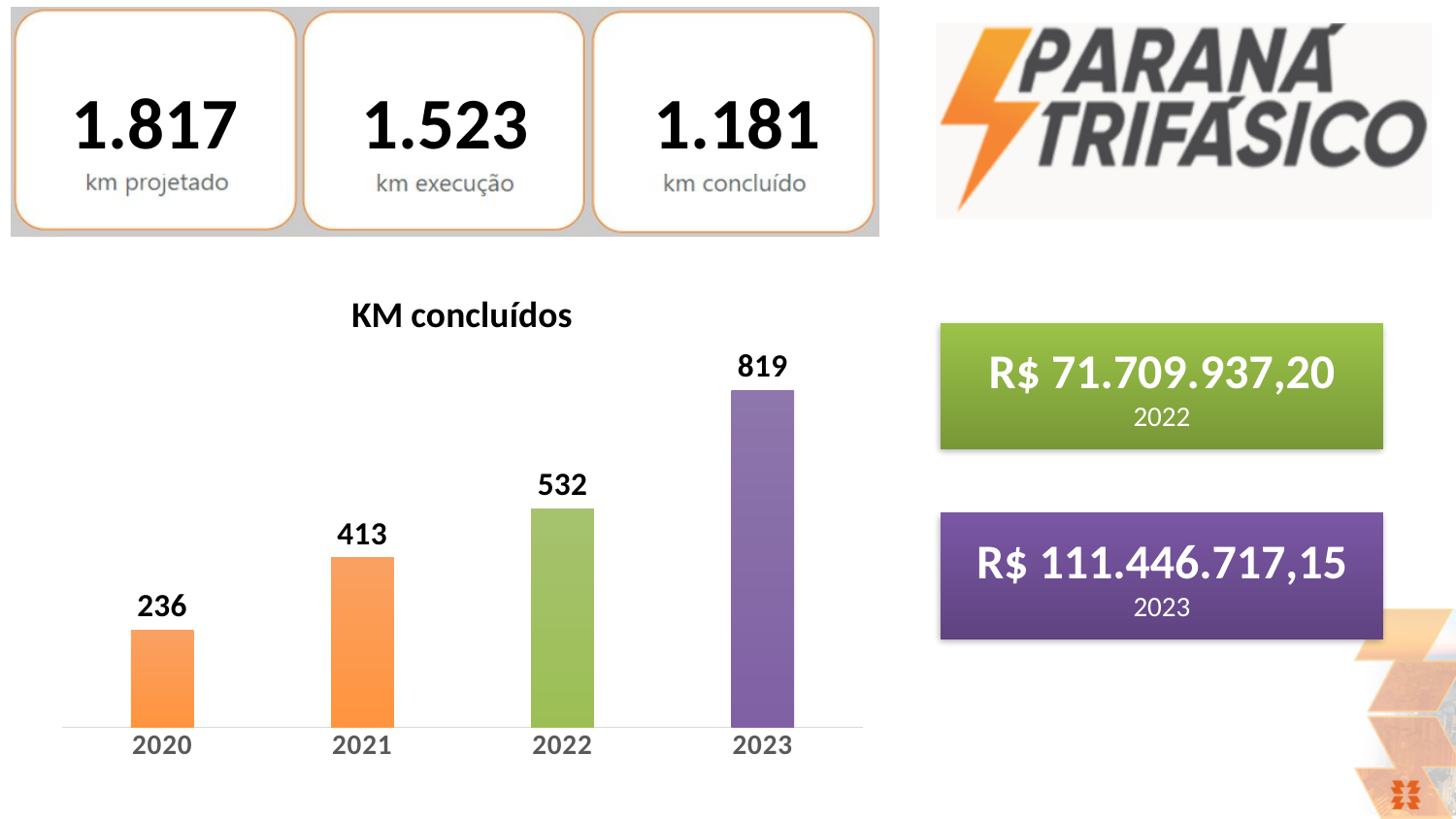
What is the value for 2023 in the KM concluídos chart? 819 What is the value for 2021 in the KM concluídos chart? 413 Do the values in the KM concluídos chart rise or fall from 2020 to 2023? rise Which year has the lowest value in the KM concluídos chart? 2020 What is the difference between the 2023 and 2022 values in the KM concluídos chart? 287 What is the value for 2022 in the KM concluídos chart? 532 How many years are shown in the KM concluídos chart? 4 Which year has the highest value in the KM concluídos chart? 2023 Which is larger in the KM concluídos chart, the value for 2021 or the value for 2022? 2022 What is the difference between the 2021 and 2020 values in the KM concluídos chart? 177 What is the value for 2020 in the KM concluídos chart? 236 What kind of chart is the KM concluídos chart? bar chart